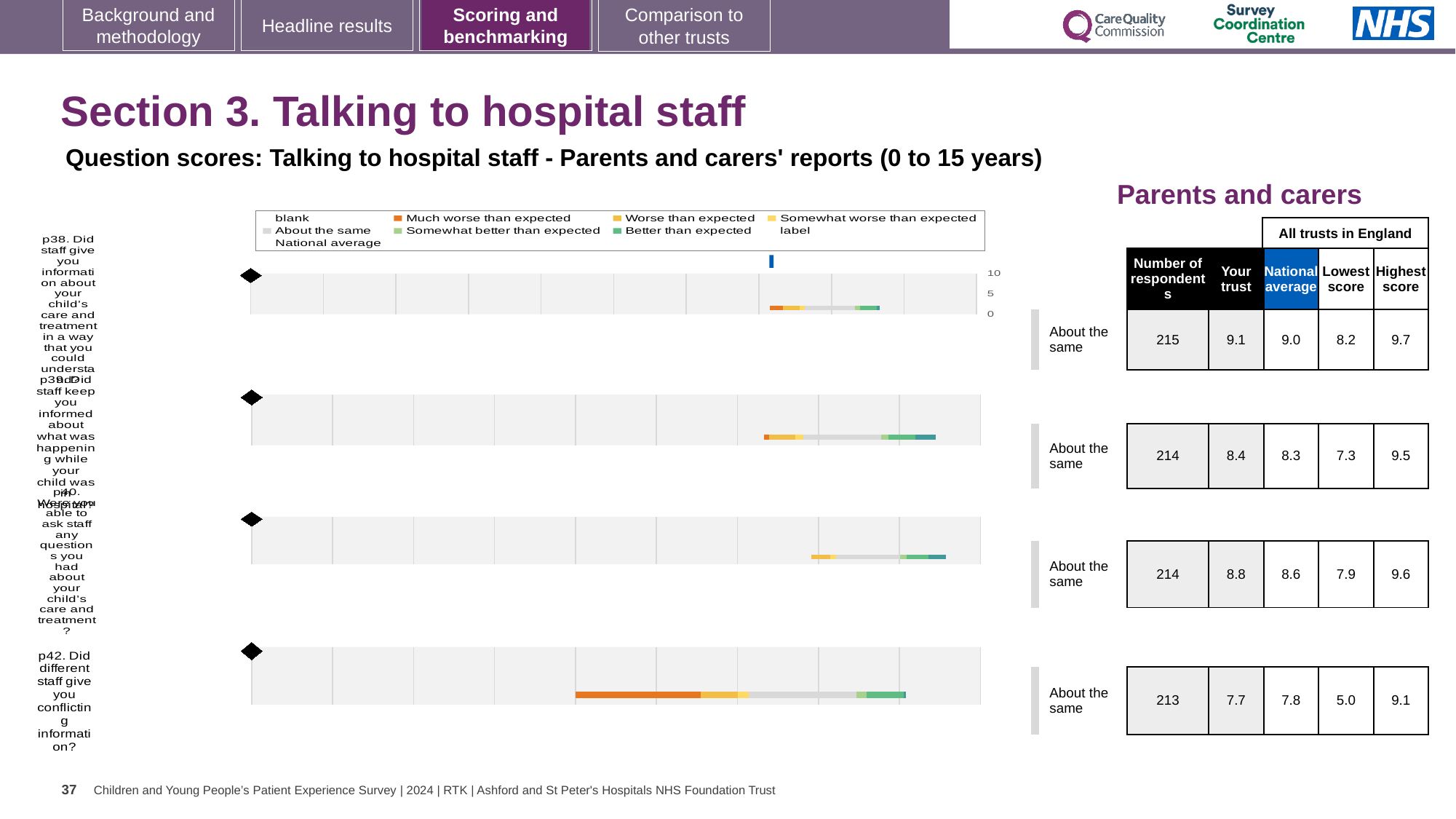
According to the legend, what does the dark green segment represent? Better than expected For p42, which is larger in the table: the 'Your trust' score or the National average? National average Which of the four questions has the highest 'Your trust' score in the table? p38 Which of the four questions has the lowest 'Your trust' score in the table? p42 In the table beside the charts, what is the National average for p39 (staff keeping you informed about what was happening)? 8.3 In the table beside the charts, what is the Lowest score for p42 (different staff giving conflicting information)? 5.0 For p40, what is the difference between the 'Your trust' score and the National average in the table? 0.2 In the table beside the charts, how many respondents answered p40 (able to ask staff any questions)? 214 In the table beside the charts, what is the 'Your trust' score for p38 (staff giving information about your child's care and treatment)? 9.1 What colour does the legend use for 'Much worse than expected'? orange How many separate bar charts are shown on the slide? 4 What kind of chart is used for the four question scores on the slide? bar chart